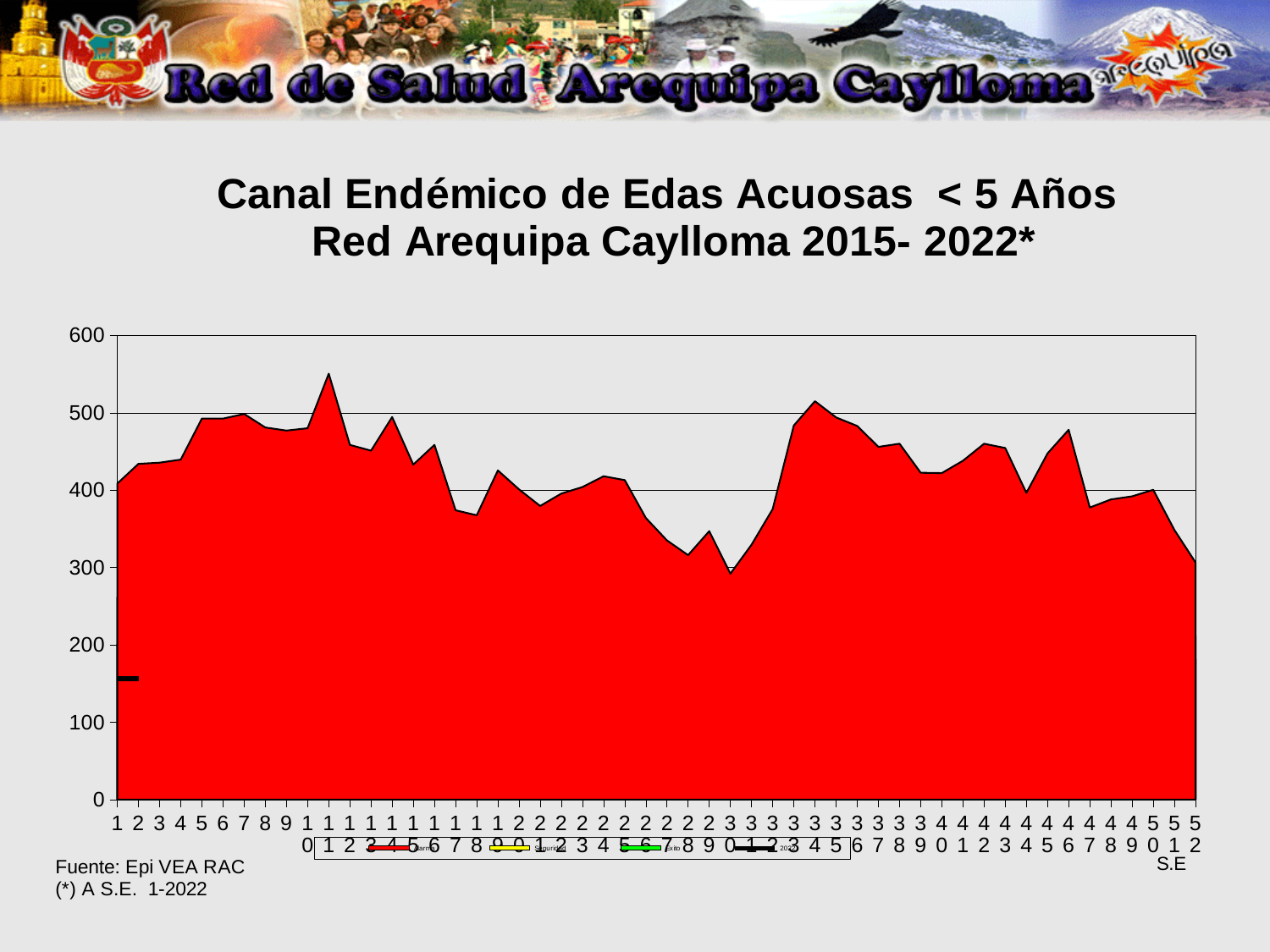
How many epidemiological weeks (S.E.) are shown along the x axis of the chart? 52 Is the value for week 2 greater or less than 400? greater Is the value for week 34 greater or less than 400? greater Is the value at week 52 higher or lower than the value at week 1? Lower Is the value for week 30 greater or less than 400? less What is the highest value shown on the vertical axis of the chart? 600 Which week has the larger value, week 11 or week 31? Week 11 What kind of chart is shown on the slide? Area chart At which week (S.E.) does the red area reach its highest point? 11 What is the title of the chart on the slide? Canal Endémico de Edas Acuosas < 5 Años Red Arequipa Caylloma 2015- 2022*